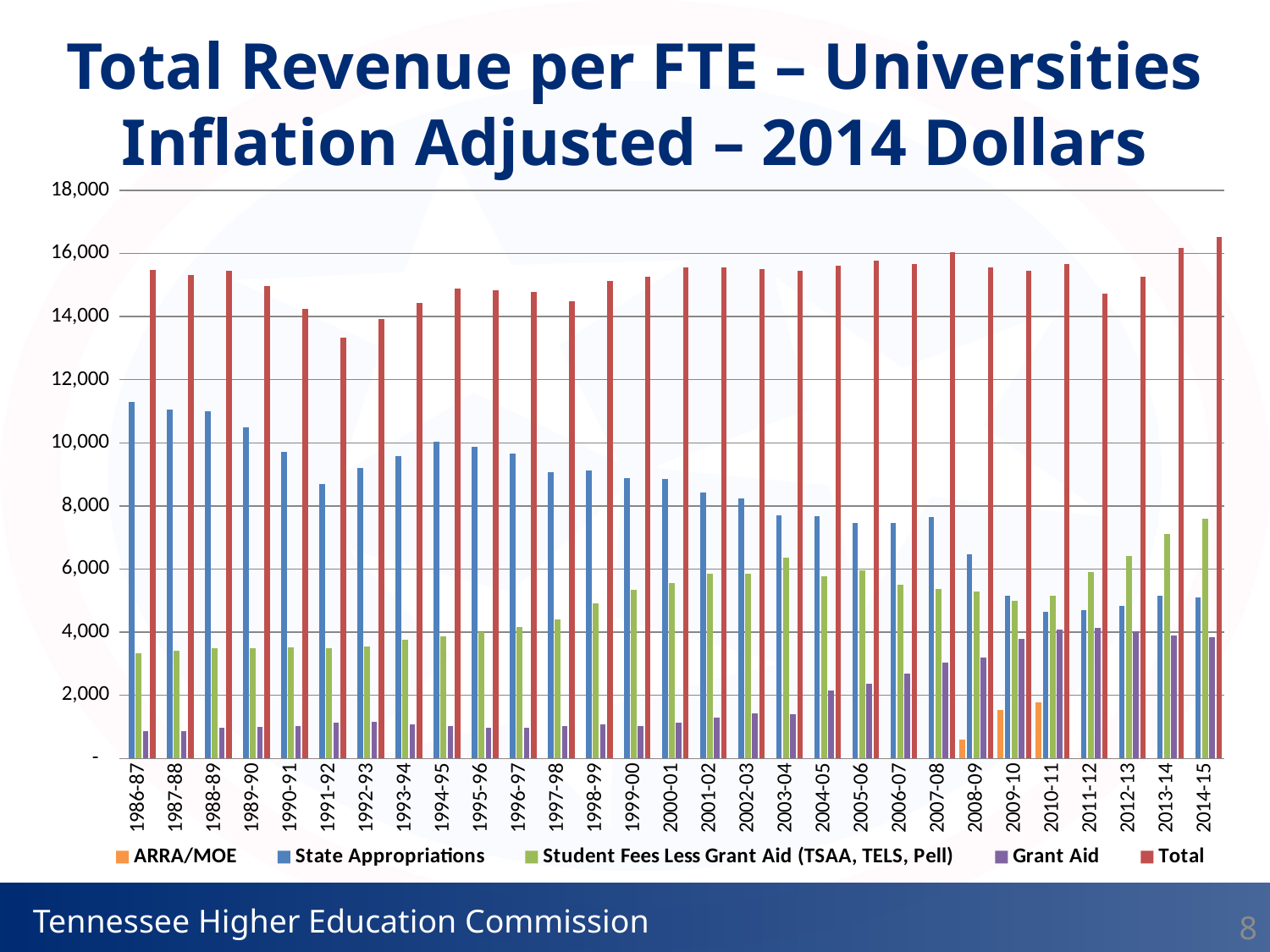
How many academic years are shown on the x axis? 29 Is the Total value for 1991-92 greater or less than 14,000? less What kind of chart is shown on the slide? Bar chart Is the State Appropriations value for 1986-87 greater or less than 10,000? greater Which year has the highest Student Fees Less Grant Aid value? 2014-15 Is the Total value for 2014-15 greater or less than 16,000? greater Which year has the highest State Appropriations value? 1986-87 Which year has the highest Total revenue per FTE? 2014-15 How many series does the legend list? 5 Does the State Appropriations series generally rise or fall from 1986-87 to 2014-15? Fall In 2014-15, which is larger: State Appropriations or Student Fees Less Grant Aid? Student Fees Less Grant Aid Which year has the lowest Total revenue per FTE? 1991-92